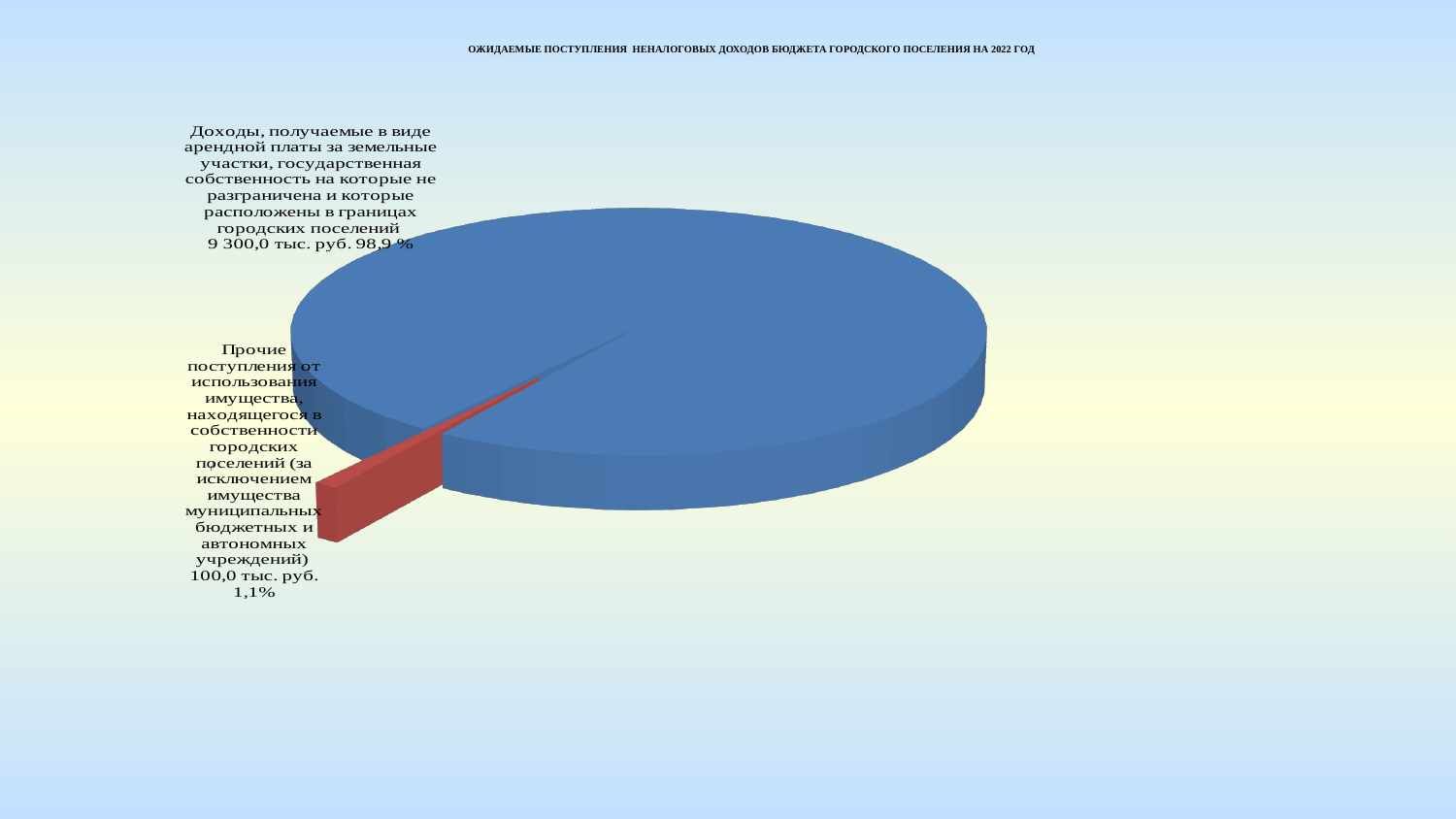
What is the difference in тыс. руб. between the land rent income slice and the "Прочие поступления" slice? 9 200,0 тыс. руб. What kind of chart is shown on the slide? Pie chart Which slice is the smallest in the pie chart? Прочие поступления от использования имущества What colour is the slice for "Прочие поступления от использования имущества..."? Red What is the value shown for "Прочие поступления от использования имущества..."? 100,0 тыс. руб. What is the value shown for "Доходы, получаемые в виде арендной платы за земельные участки..."? 9 300,0 тыс. руб. What share of the pie does the slice for land rent income ("Доходы, получаемые в виде арендной платы за земельные участки...") represent? 98,9 % What is the total of the two slices in тыс. руб.? 9 400,0 тыс. руб. What share of the pie does the slice "Прочие поступления от использования имущества..." represent? 1,1% Which is larger: the land rent income slice or the "Прочие поступления" slice? Land rent income (Доходы, получаемые в виде арендной платы за земельные участки) Which slice is the largest in the pie chart? Доходы, получаемые в виде арендной платы за земельные участки How many slices does the pie chart have? 2